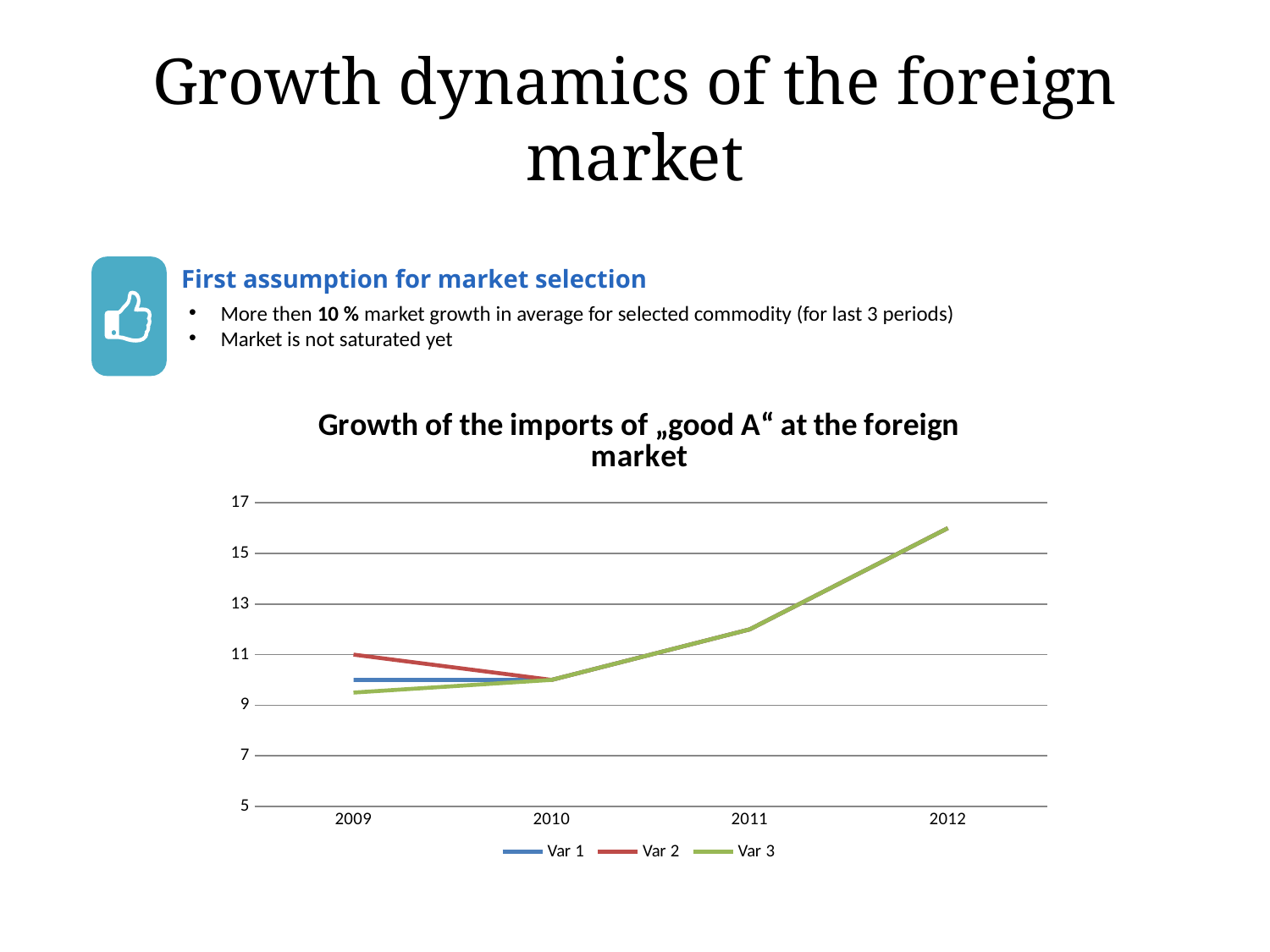
In 2009, which is larger: Var 2 or Var 3? Var 2 How many years are shown on the x axis? 4 Do the values for Var 3 rise or fall from 2010 to 2012? rise What kind of chart is shown on the slide? line chart How many series does the legend list? 3 Does Var 2 rise or fall from 2009 to 2010? fall In which year does Var 3 reach its highest value? 2012 Is the value for Var 3 in 2009 greater or less than 11? less Is the value for Var 3 in 2012 greater or less than 15? greater Which series are listed in the legend? Var 1, Var 2, Var 3 What is the title of the chart? Growth of the imports of „good A“ at the foreign market Is the value for Var 3 in 2011 greater or less than 13? less